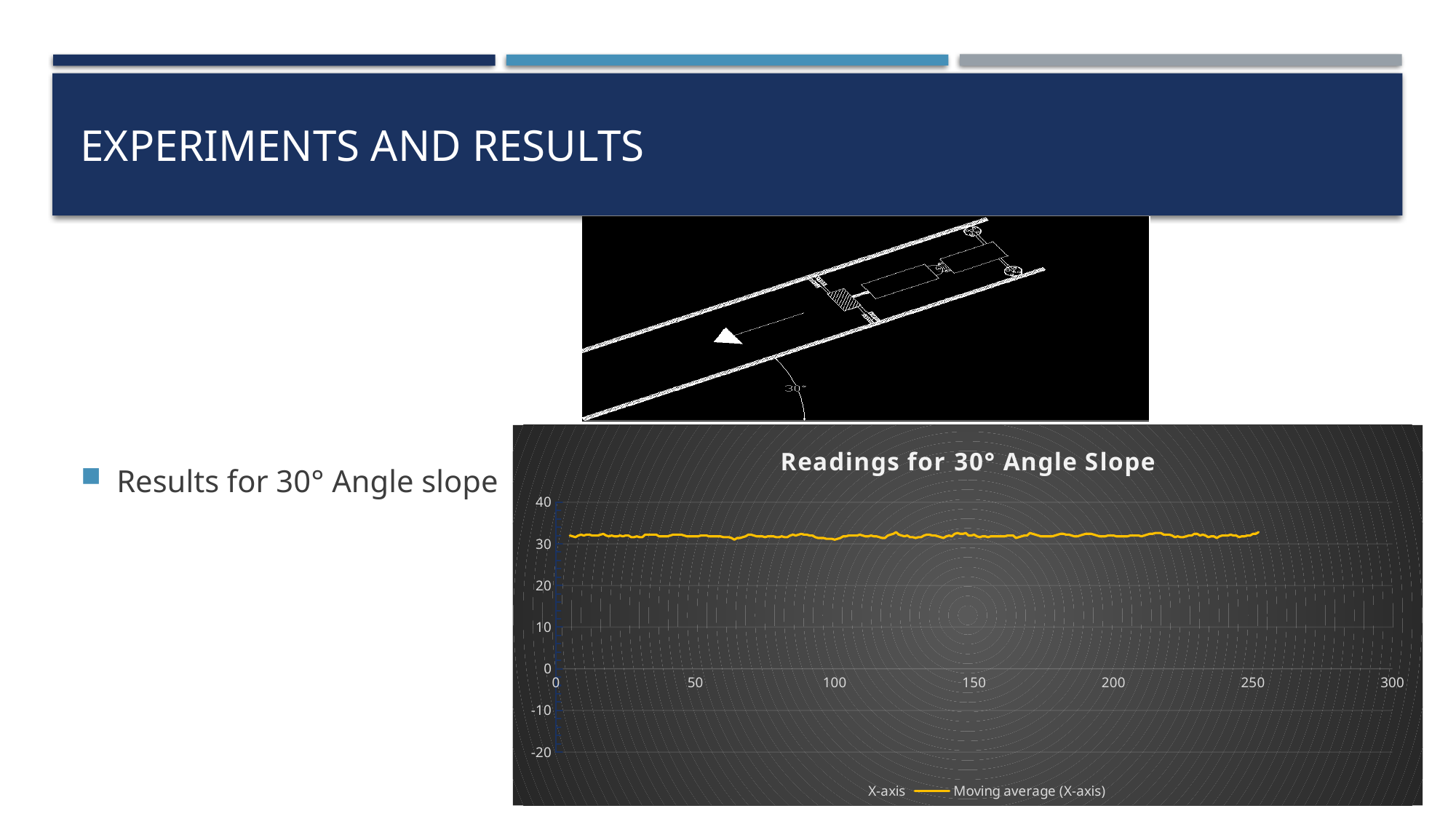
What is the title of the chart? Readings for 30° Angle Slope What is the lowest tick value shown on the vertical axis? -20 Is the value of the moving average line at x = 50 greater or less than 10? greater Is the value of the moving average line at x = 100 greater or less than 20? greater What is the largest tick value shown on the horizontal axis? 300 How many series does the chart legend list? 2 Does the moving average line rise, fall, or stay roughly flat as x increases from 0 to 250? stays roughly flat Is the value of the moving average line at x = 200 greater or less than 40? less What kind of chart is shown on the slide? line chart